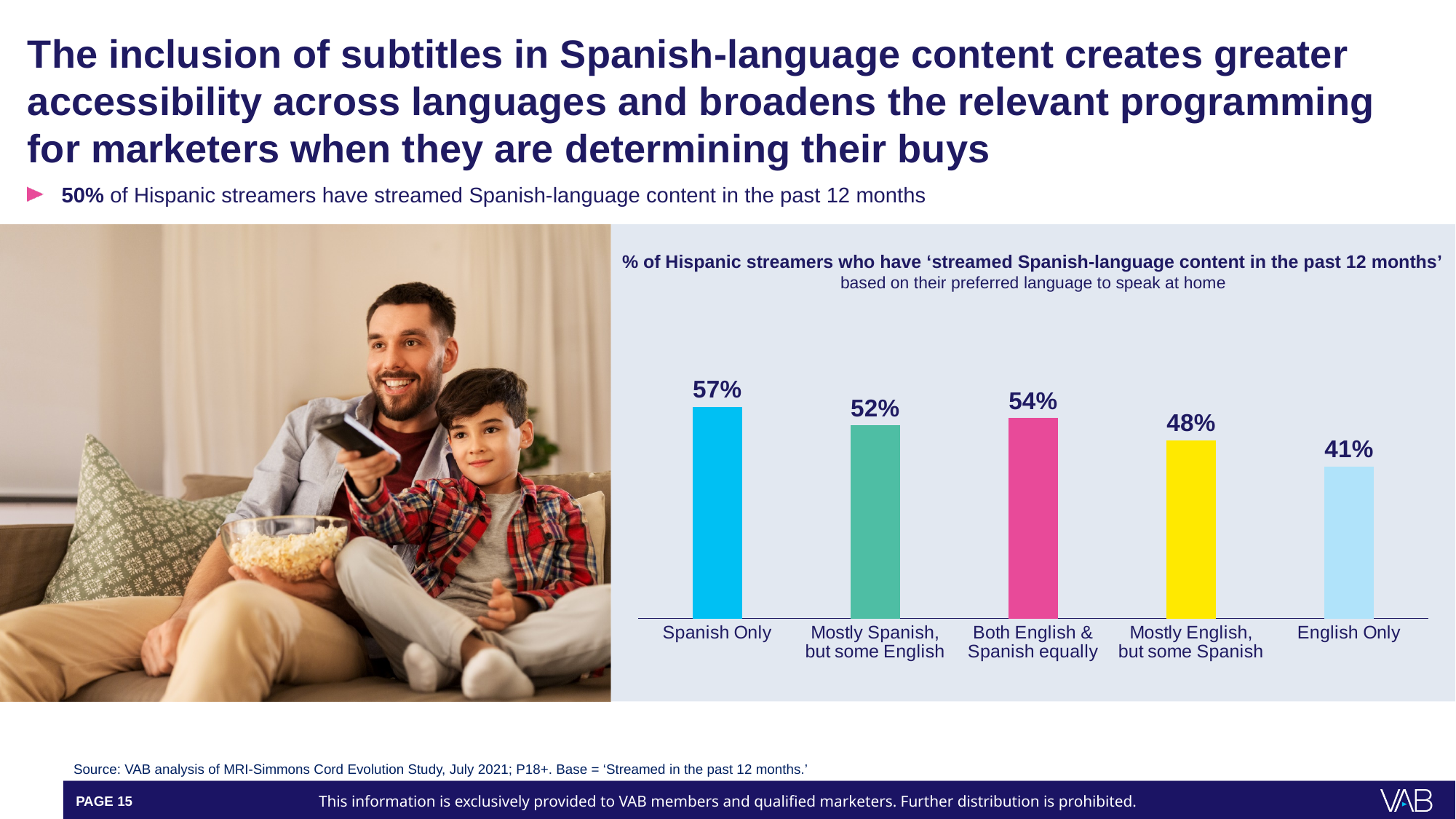
What is the value shown for the 'English Only' category? 41% How many preferred-language categories are shown in the chart? 5 What is the difference in percentage points between the Spanish Only and English Only categories? 16 What kind of chart is shown on the slide? Bar chart Which is larger: the value for 'Mostly Spanish, but some English' or the value for 'Both English & Spanish equally'? Both English & Spanish equally Which preferred-language category has the highest percentage? Spanish Only What percentage of Hispanic streamers who prefer Spanish Only at home have streamed Spanish-language content in the past 12 months? 57% What is the value shown for the 'Both English & Spanish equally' category? 54% What colour is the bar for the 'Mostly English, but some Spanish' category? Yellow What is the value shown for the 'Mostly English, but some Spanish' category? 48% Which preferred-language category has the lowest percentage? English Only Do the values generally rise or fall moving from Spanish Only to English Only along the x axis? Fall